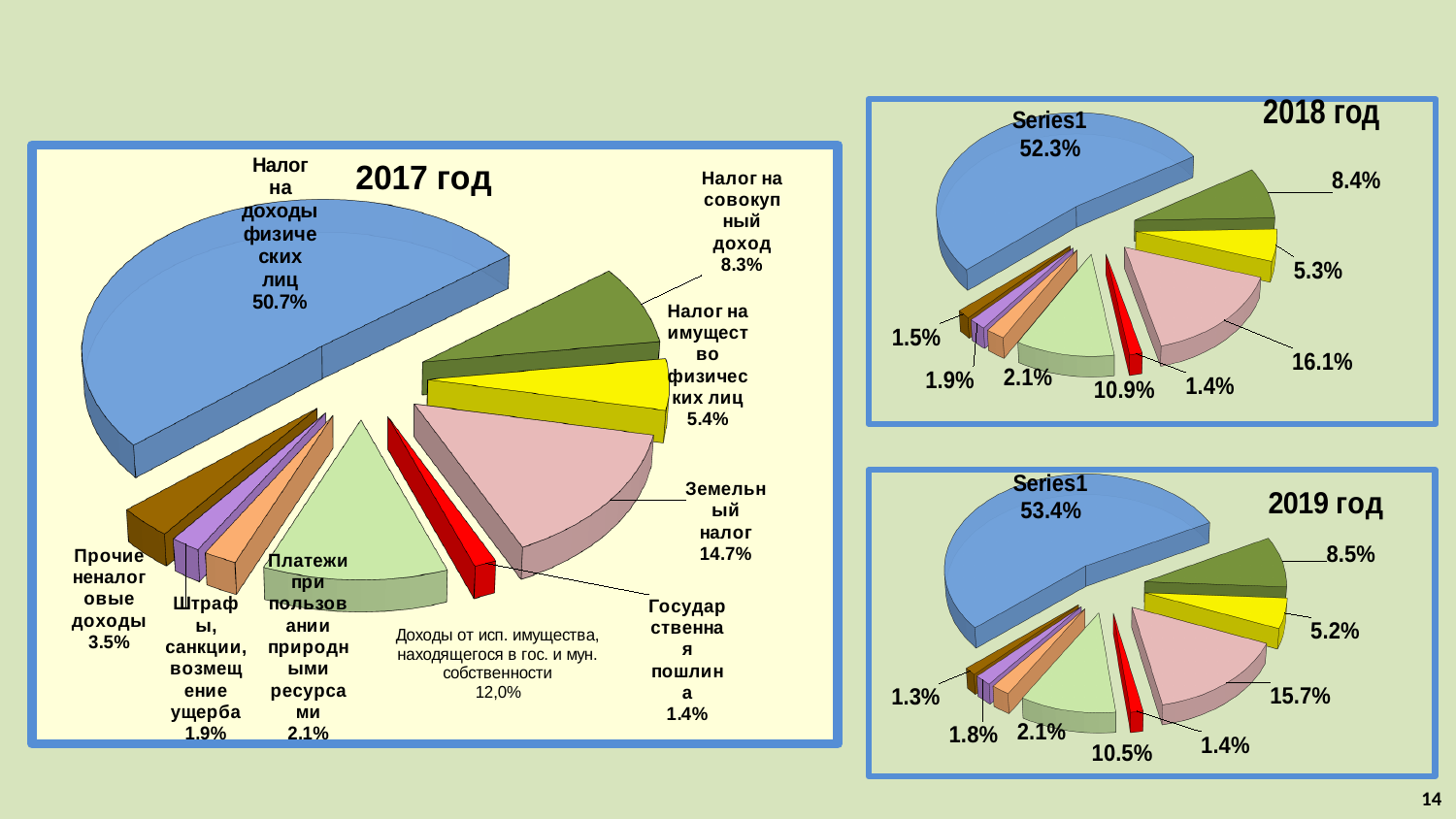
How many slices does the 2017 год chart have? 9 In the 2017 год chart, which category has the smallest share? Государственная пошлина In the 2017 год chart, which is larger: Прочие неналоговые доходы or Платежи при пользовании природными ресурсами? Прочие неналоговые доходы In the 2019 год chart, what is the share of the smallest slice? 1.3% In the 2017 год chart, what is the difference between Налог на совокупный доход and Налог на имущество физических лиц? 2.9% In the 2017 год chart, which category has the largest share? Налог на доходы физических лиц In the 2017 год chart, what share does Налог на доходы физических лиц have? 50.7% What type of chart is the 2017 год chart? Pie chart In the 2017 год chart, what share is shown for Доходы от исп. имущества, находящегося в гос. и мун. собственности? 12,0% In the 2018 год chart, what is the share of the largest slice (Series1)? 52.3% What is the title of the chart in the bottom-right of the slide? 2019 год In the 2017 год chart, what is the value for Земельный налог? 14.7%